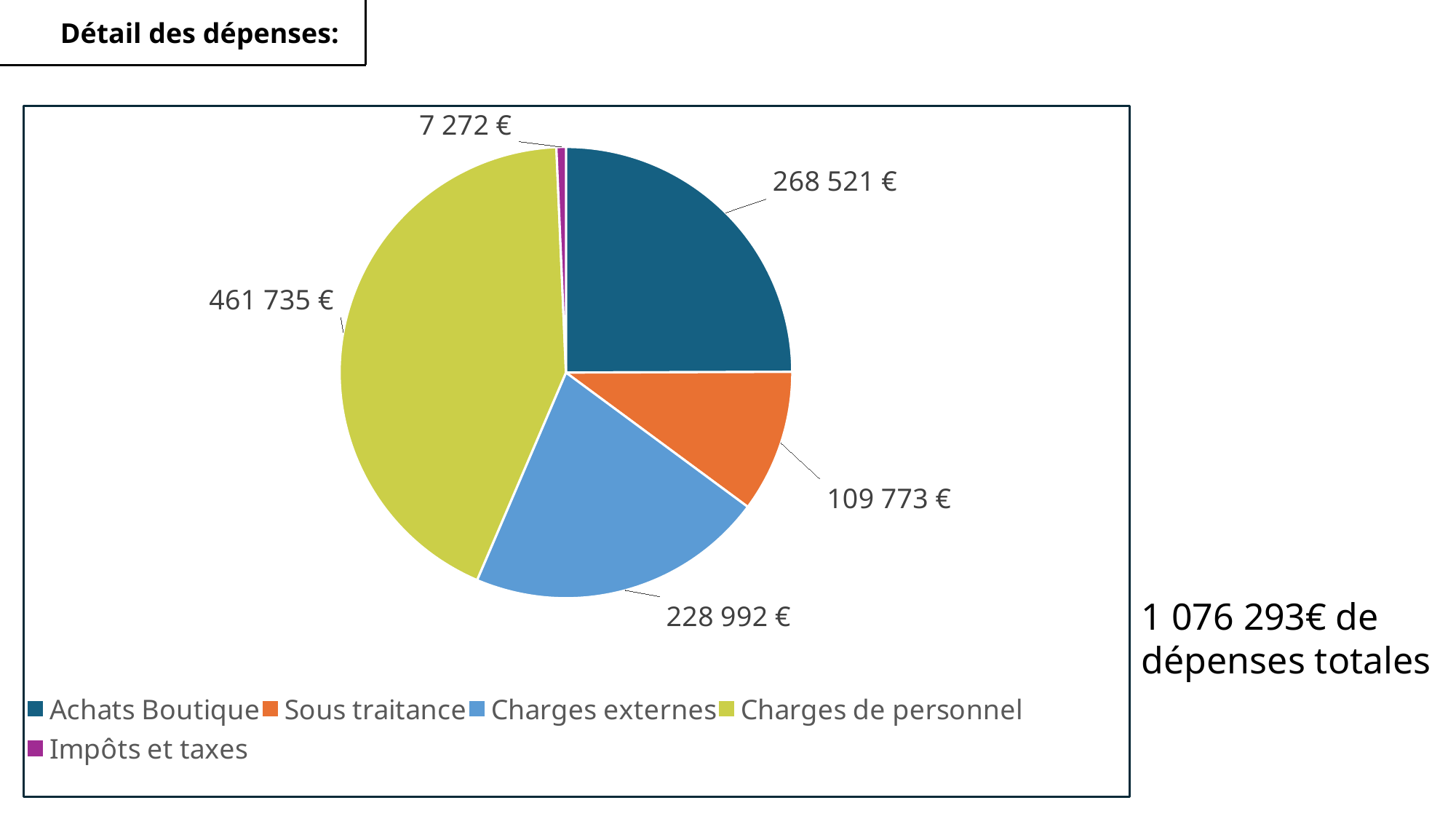
What is the total of all expenses shown on the slide? 1 076 293 € How many categories does the pie chart have? 5 What is the value for Charges de personnel? 461 735 € What kind of chart is shown on the slide? Pie chart What is the difference between Charges de personnel and Achats Boutique? 193 214 € Which category has the smallest slice of the pie? Impôts et taxes What is the value for Achats Boutique? 268 521 € What is the difference between Charges externes and Sous traitance? 119 219 € Which is larger, Achats Boutique or Charges externes? Achats Boutique What is the value for Impôts et taxes? 7 272 € What is the value for Sous traitance? 109 773 € Which category has the largest slice of the pie? Charges de personnel